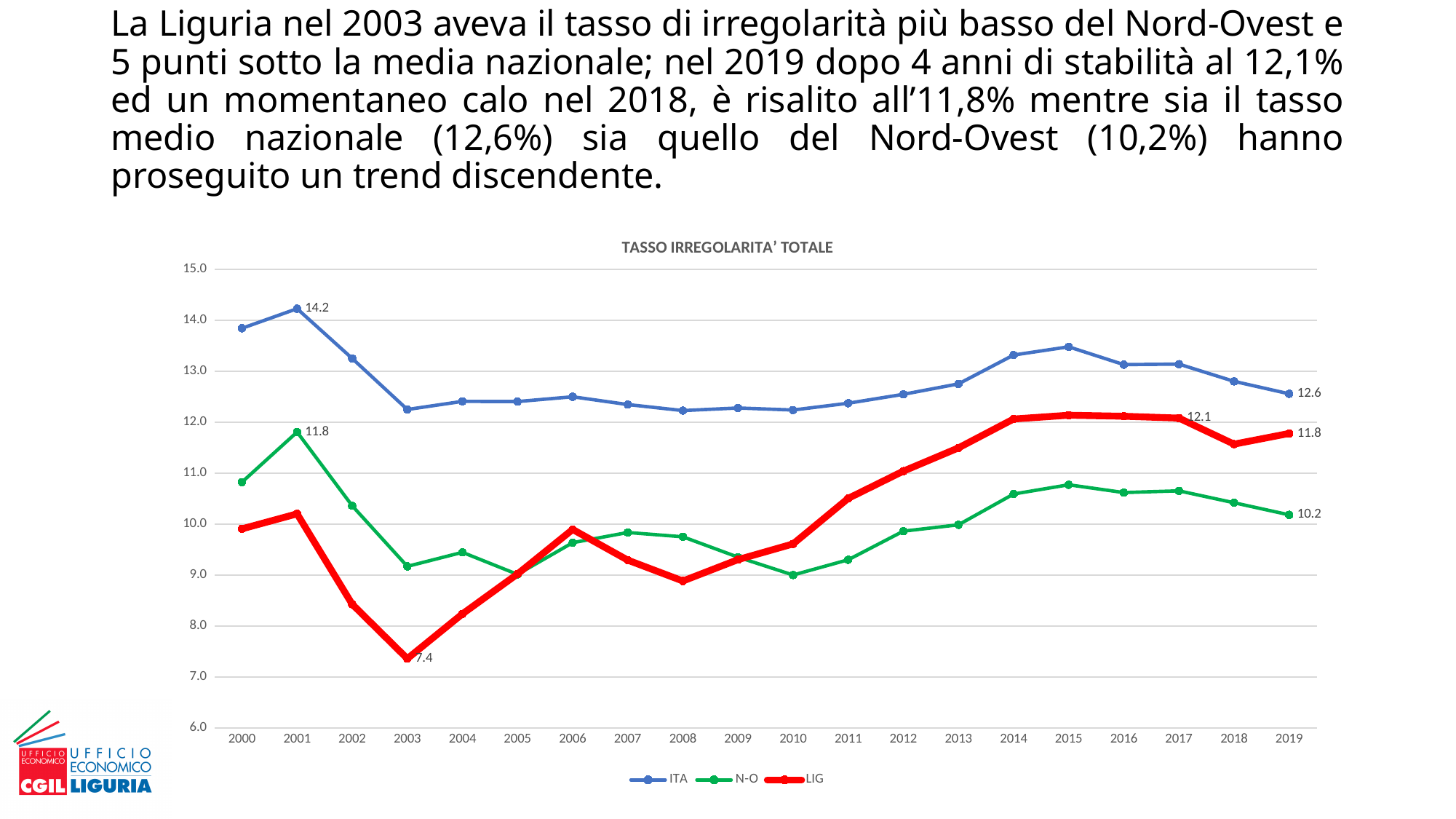
What is the difference between the ITA value and the N-O value in 2019? 2.4 Which series has the highest value in 2019? ITA What is the value of the LIG series in 2003? 7.4 Which is larger in 2003, the N-O value or the LIG value? N-O What type of chart is shown on the slide? line chart What is the value of the ITA series in 2001? 14.2 What is the title of the chart? TASSO IRREGOLARITA' TOTALE How many years are shown on the x axis of the chart? 20 How many series does the chart legend list? 3 What is the value of the LIG series in 2017? 12.1 What is the value of the N-O series in 2019? 10.2 Is the value for LIG in 2008 greater or less than 9.0? less